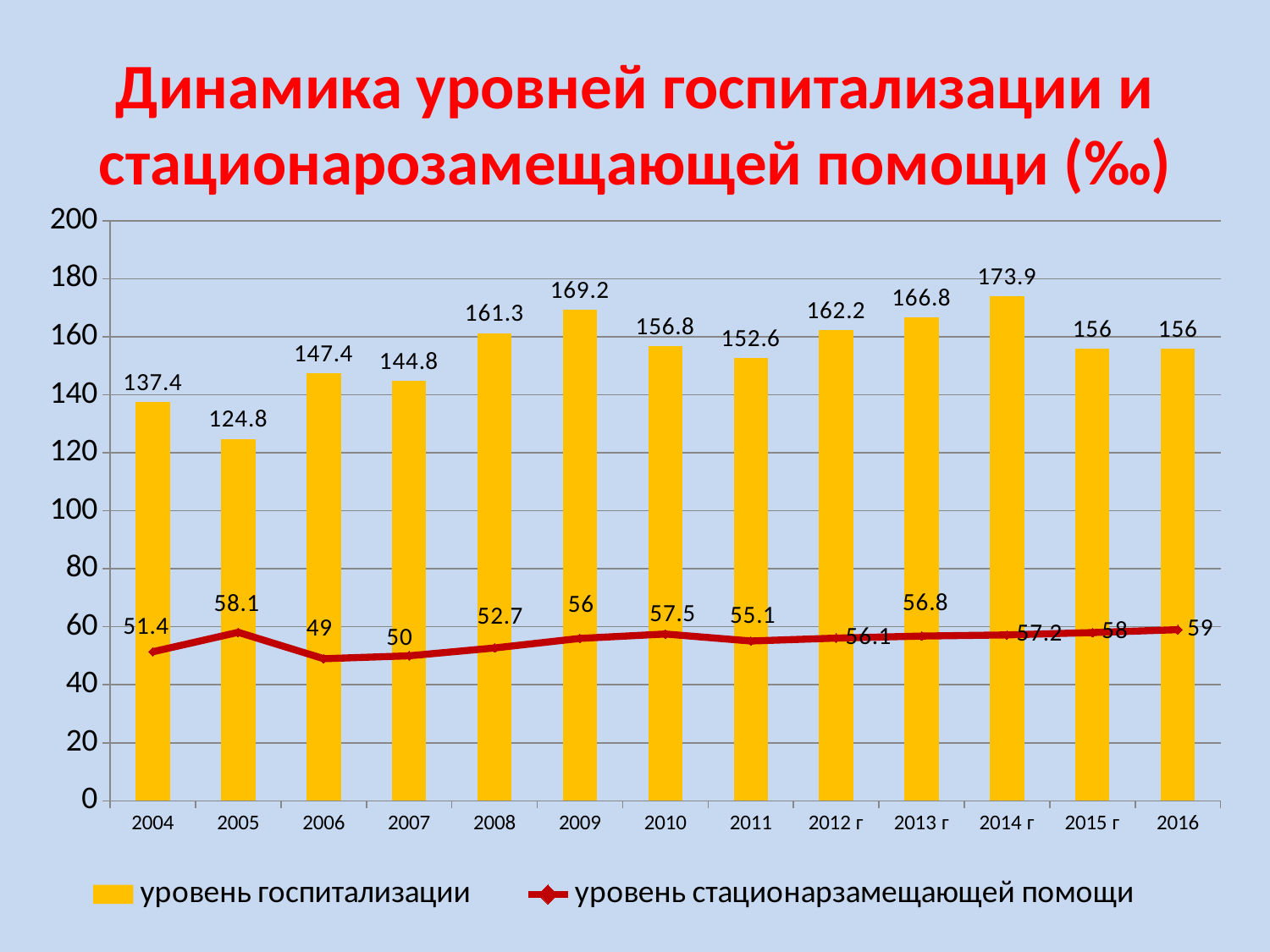
What is the value of уровень стационарзамещающей помощи for 2016? 59 Which year has the lowest value of уровень госпитализации? 2005 Which year has the lowest value of уровень стационарзамещающей помощи? 2006 Which year has the highest value of уровень госпитализации? 2014 г What kind of chart is used for уровень госпитализации? bar chart What colour are the bars for уровень госпитализации? yellow Which is larger: уровень госпитализации in 2009 or in 2013 г? 2009 What is the difference between уровень госпитализации in 2014 г and in 2005? 49.1 What is the value of уровень госпитализации for 2004? 137.4 How many years are shown on the x axis? 13 Is the value of уровень госпитализации for 2011 greater or less than 140? greater How many series does the legend list? 2